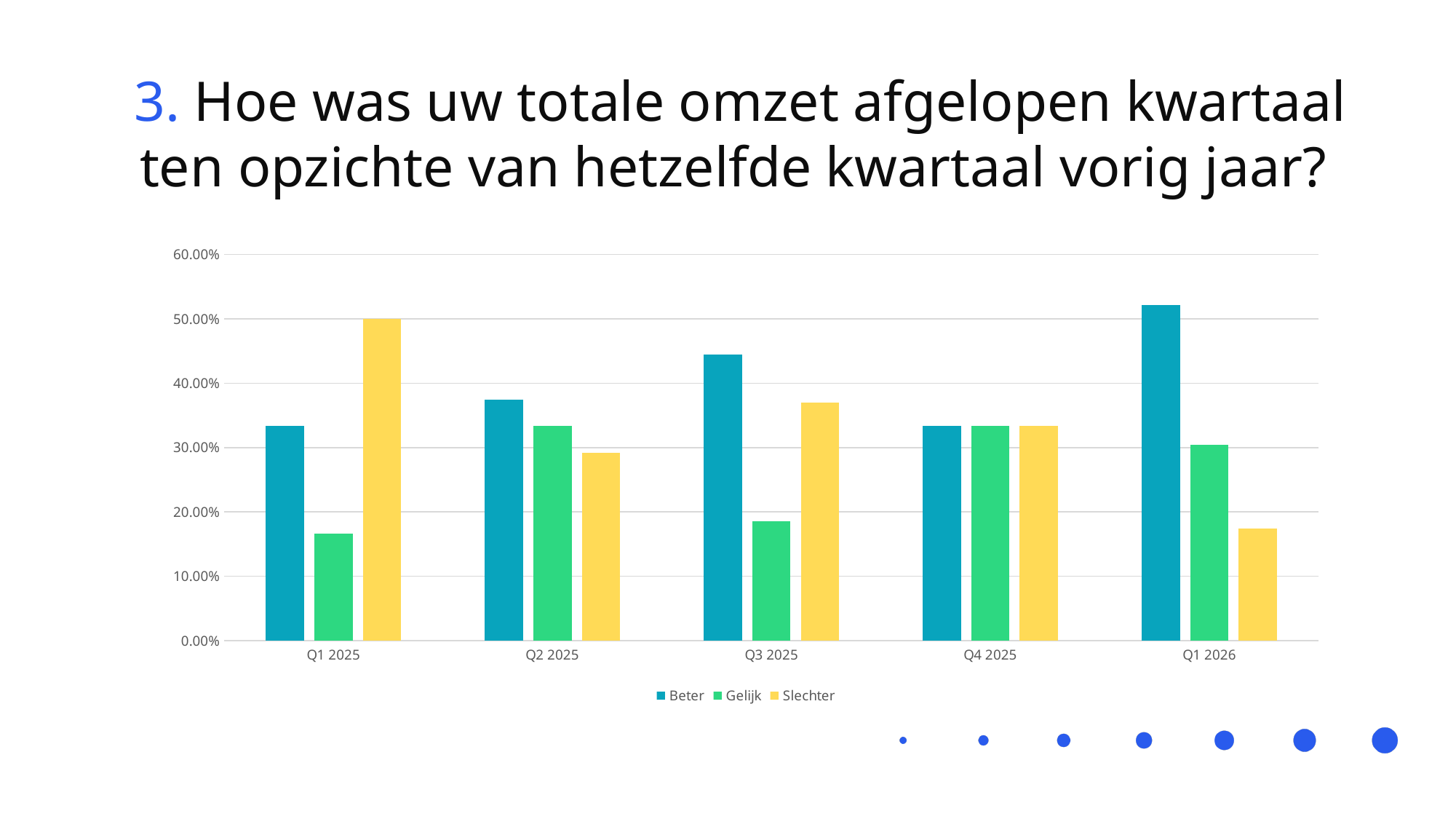
What kind of chart is shown on the slide? bar chart How many series does the legend list? 3 How many quarters are shown on the x axis? 5 Which series is shown in yellow? Slechter In which quarter is the Gelijk series lowest? Q1 2025 Is the value for Gelijk in Q1 2025 greater or less than 20.00%? less Is the value for Beter in Q1 2026 greater or less than 50.00%? greater In Q3 2025, which is larger: Beter or Slechter? Beter Is the value for Beter in Q3 2025 greater or less than 40.00%? greater Does the Slechter series rise or fall from Q4 2025 to Q1 2026? fall In which quarter is the Beter series highest? Q1 2026 What is the value for Slechter in Q1 2025? 50.00%